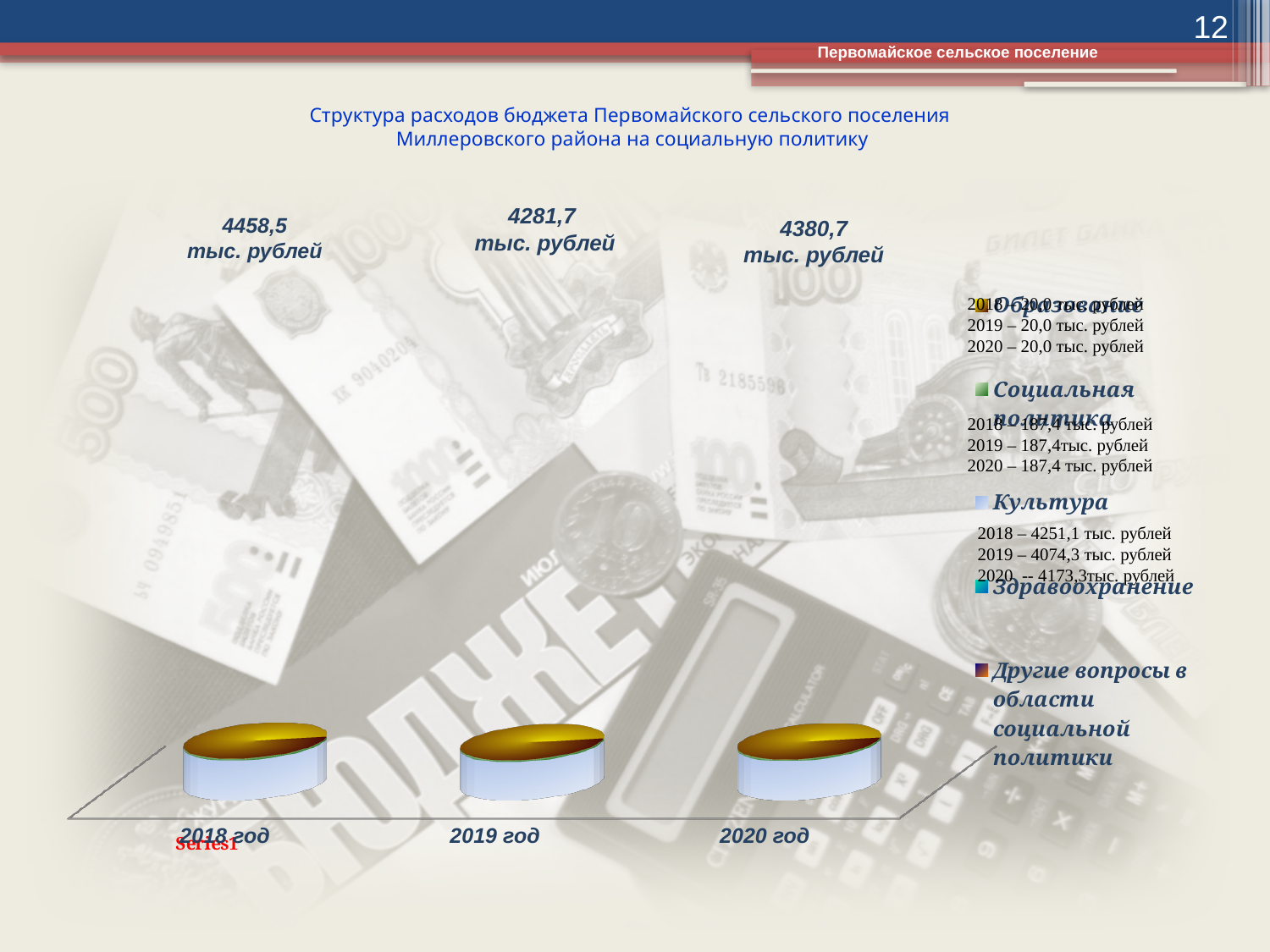
How many years are shown on the x axis of the chart? 3 Which year has the highest value? 2018 год How many entries does the chart legend list? 5 Which is larger, the value for 2018 год or the value for 2020 год? 2018 год What is the difference between the values for 2018 год and 2019 год? 176,8 тыс. рублей What is the difference between the values for 2020 год and 2019 год? 99,0 тыс. рублей What is the value shown for 2019 год? 4281,7 тыс. рублей What kind of chart is shown on the slide? bar chart Which year has the lowest value? 2019 год What is the value shown for 2020 год? 4380,7 тыс. рублей What is the value shown for 2018 год? 4458,5 тыс. рублей Does the value rise or fall from 2018 год to 2019 год? fall